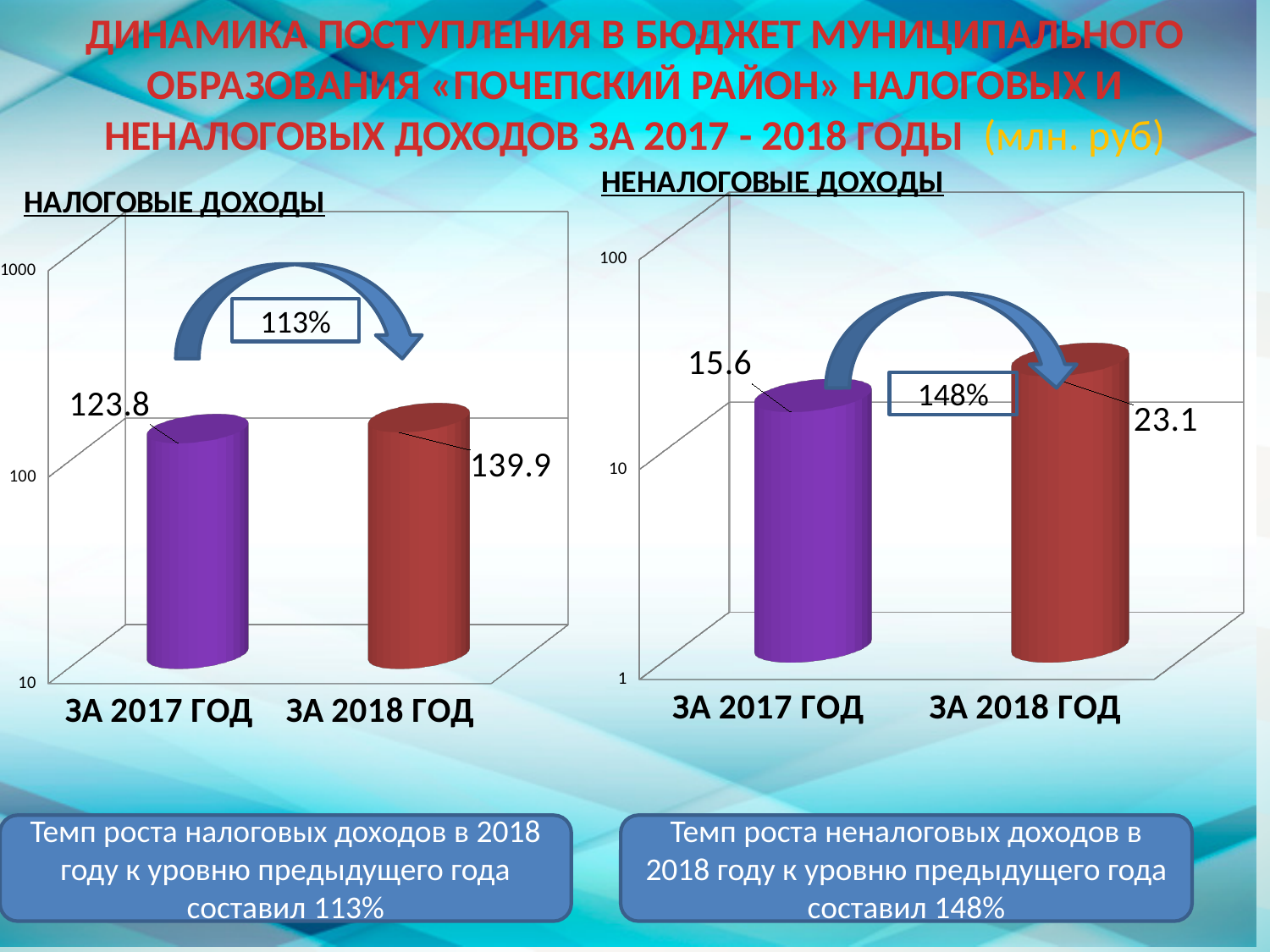
In the НАЛОГОВЫЕ ДОХОДЫ chart, which year has the higher value? ЗА 2018 ГОД In the НЕНАЛОГОВЫЕ ДОХОДЫ chart, what is the value for ЗА 2018 ГОД? 23.1 In the НЕНАЛОГОВЫЕ ДОХОДЫ chart, what is the difference between the 2018 and 2017 values? 7.5 In the НАЛОГОВЫЕ ДОХОДЫ chart, what is the difference between the 2018 and 2017 values? 16.1 What kind of chart is the НЕНАЛОГОВЫЕ ДОХОДЫ chart? Bar chart In the НАЛОГОВЫЕ ДОХОДЫ chart, what percentage is shown in the box under the arrow between the two bars? 113% In the НЕНАЛОГОВЫЕ ДОХОДЫ chart, is the value for ЗА 2018 ГОД greater or less than 10? greater In the НЕНАЛОГОВЫЕ ДОХОДЫ chart, which year has the lower value? ЗА 2017 ГОД In the НАЛОГОВЫЕ ДОХОДЫ chart, what is the value for ЗА 2018 ГОД? 139.9 How many categories are shown on the x axis of the НАЛОГОВЫЕ ДОХОДЫ chart? 2 In the НЕНАЛОГОВЫЕ ДОХОДЫ chart, what is the value for ЗА 2017 ГОД? 15.6 In the НАЛОГОВЫЕ ДОХОДЫ chart, what is the value for ЗА 2017 ГОД? 123.8